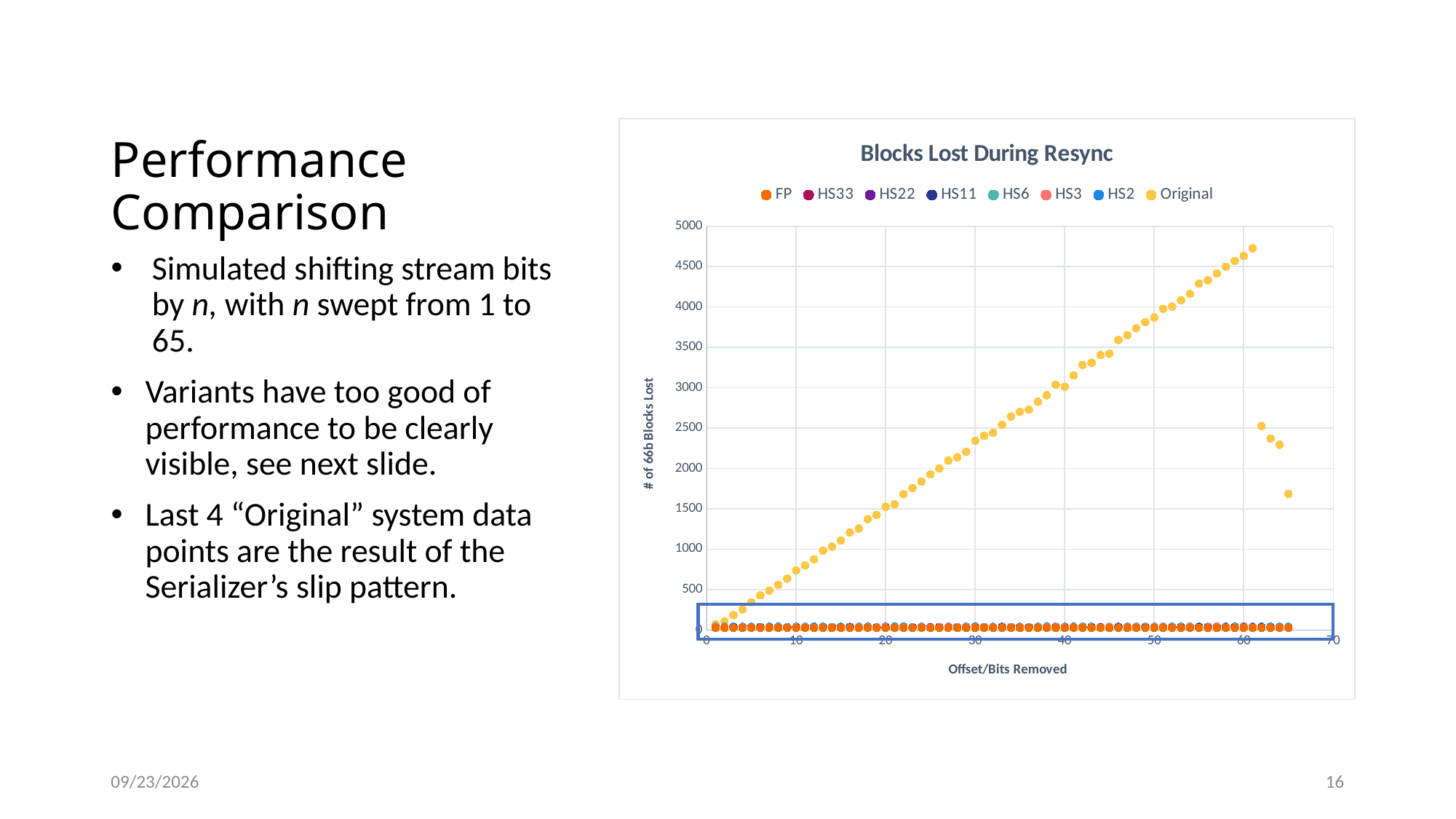
Is the Original value at an offset of 30 greater or less than 2000? greater Is the Original value at an offset of 65 greater or less than 2000? less What is the label of the x axis? Offset/Bits Removed Do the Original values rise or fall as the offset increases from 1 to 60? rise At an offset of 40, which is larger: the Original value or the FP value? Original Is the FP value at an offset of 50 greater or less than 500? less How many series does the chart legend list? 8 What is the title of the chart? Blocks Lost During Resync Which series reaches the highest number of blocks lost? Original What kind of chart is shown on the slide? scatter chart